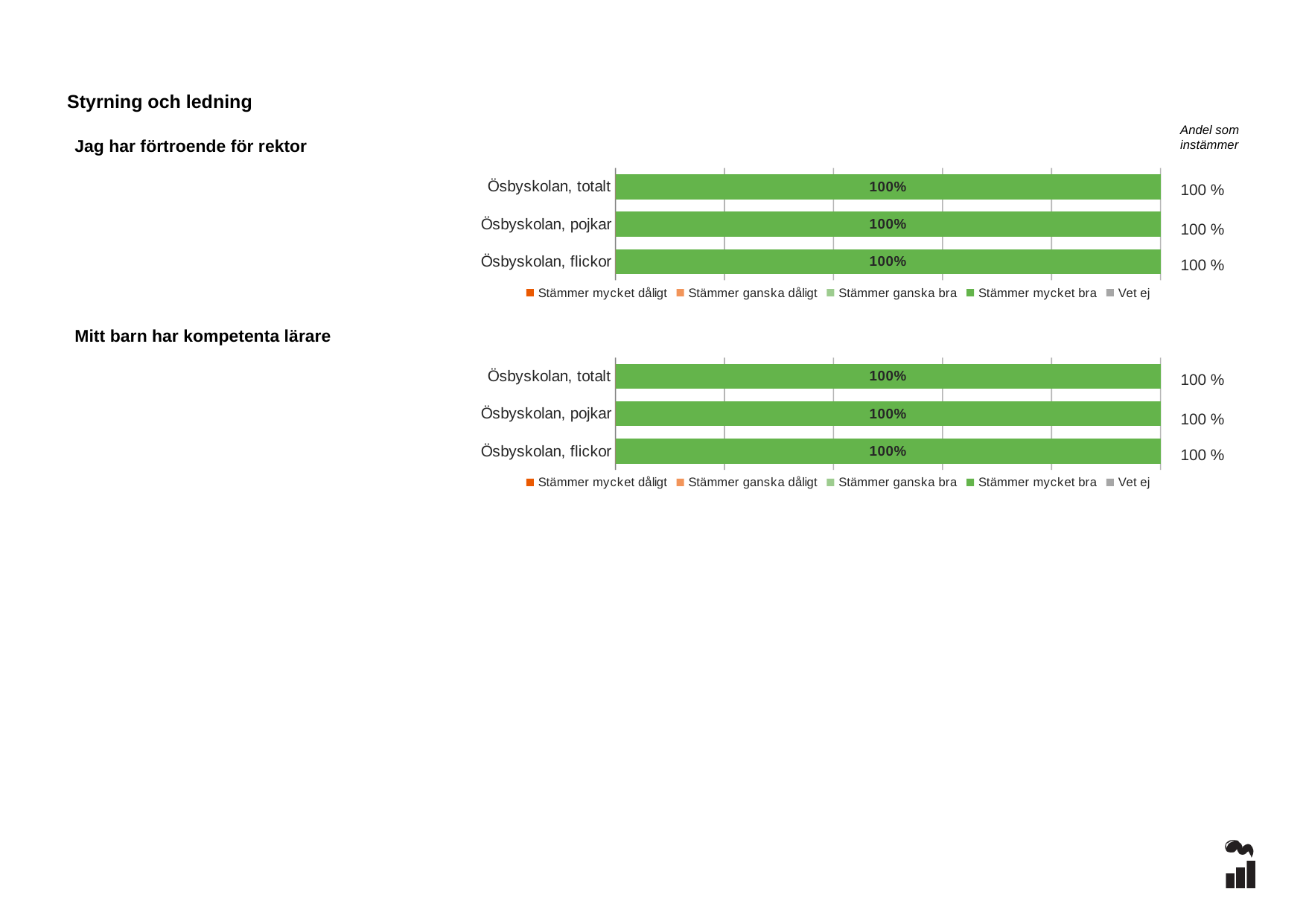
How many categories are shown in the chart 'Jag har förtroende för rektor'? 3 In the chart 'Jag har förtroende för rektor', what is the 'Andel som instämmer' value shown for Ösbyskolan, pojkar? 100 % How many categories are shown in the chart 'Mitt barn har kompetenta lärare'? 3 How many series does the legend list in the chart 'Jag har förtroende för rektor'? 5 In the chart 'Mitt barn har kompetenta lärare', what is the total of the stacked bar for Ösbyskolan, flickor? 100% Which legend entry is shown in dark green in the chart 'Mitt barn har kompetenta lärare'? Stämmer mycket bra In the chart 'Jag har förtroende för rektor', what is the value for 'Stämmer mycket bra' for Ösbyskolan, totalt? 100% How many series does the legend list in the chart 'Mitt barn har kompetenta lärare'? 5 In the chart 'Mitt barn har kompetenta lärare', what is the value for 'Stämmer mycket bra' for Ösbyskolan, totalt? 100% What kind of chart is 'Jag har förtroende för rektor'? Bar chart In the chart 'Jag har förtroende för rektor', what is the value for 'Stämmer mycket bra' for Ösbyskolan, flickor? 100% In the chart 'Mitt barn har kompetenta lärare', what is the value for 'Stämmer mycket bra' for Ösbyskolan, pojkar? 100%